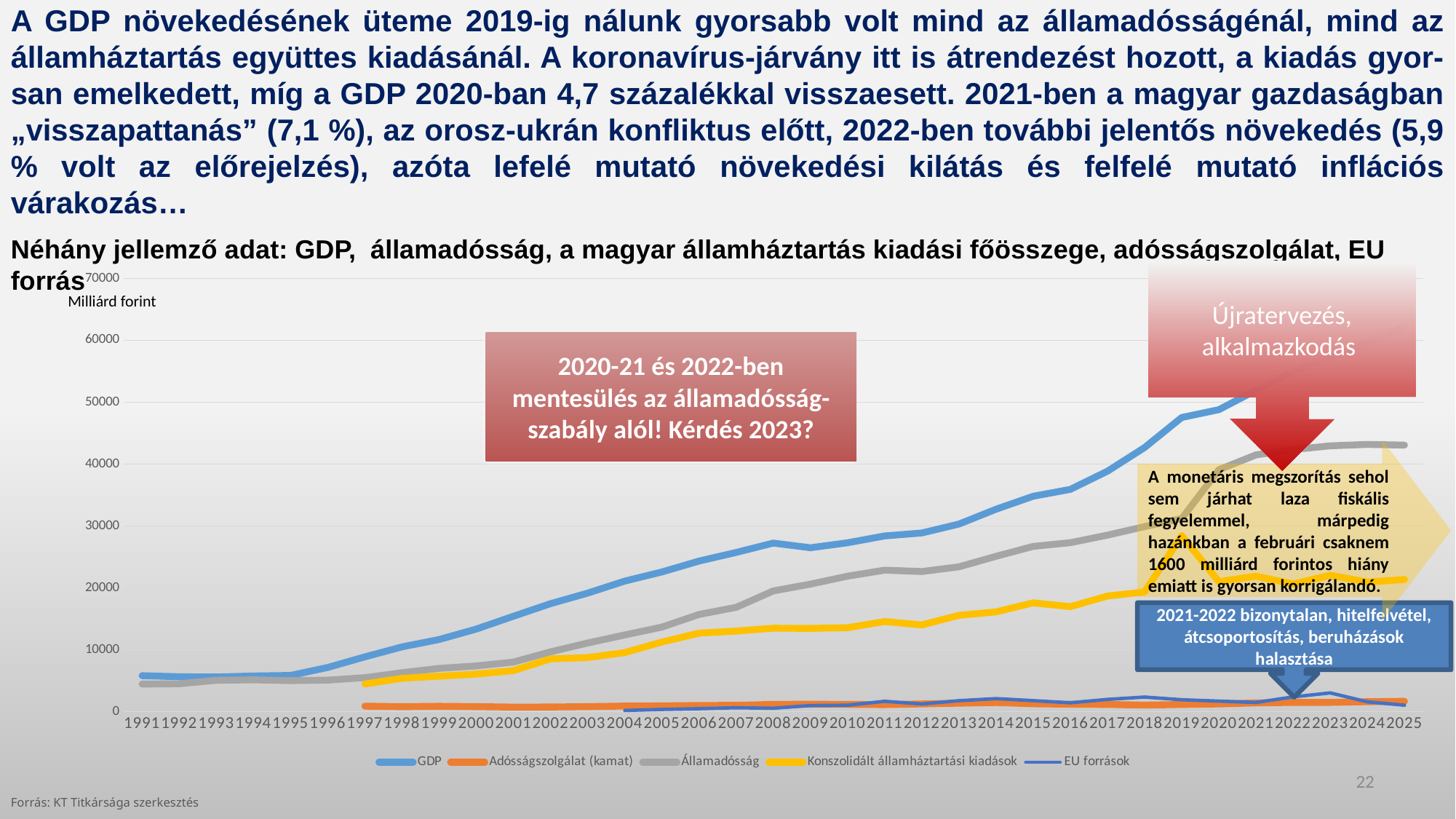
Which is larger in 2019, GDP or Államadósság? GDP What is the first year shown on the x axis of the chart? 1991 What unit is given for the y axis of the chart? Milliárd forint Which is larger in 2025, Államadósság or Konszolidált államháztartási kiadások? Államadósság Is the value of Államadósság in 2025 greater or less than 40000? greater How many years are shown along the x axis of the chart? 35 Is the value of GDP in 2019 greater or less than 40000? greater Does the GDP series rise or fall from 1991 to 2019? rise How many series does the chart legend list? 5 What kind of chart is shown on the slide? line chart Is the value of GDP in 1991 greater or less than 10000? less